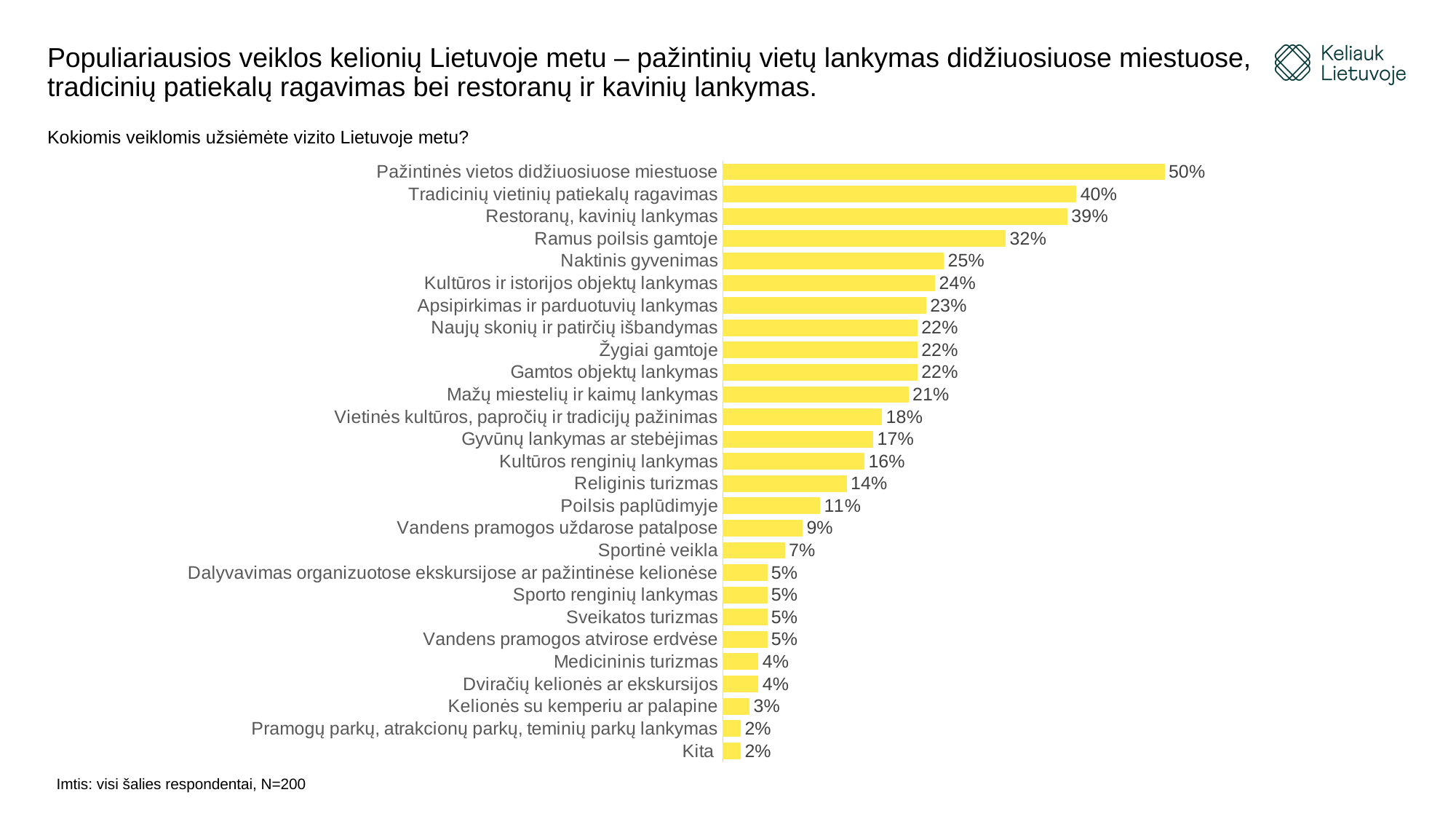
What is the value shown for "Religinis turizmas"? 14% What type of chart is shown on the slide? Bar chart What is the value shown for "Kita"? 2% Which is larger: the value for "Poilsis paplūdimyje" or the value for "Sportinė veikla"? Poilsis paplūdimyje What colour are the bars in the chart? Yellow What is the value shown for "Ramus poilsis gamtoje"? 32% What is the difference between the values for "Tradicinių vietinių patiekalų ragavimas" and "Naktinis gyvenimas"? 15% What percentage of respondents chose "Pažintinės vietos didžiuosiuose miestuose"? 50% What is the sample size stated below the chart? N=200 What is the lowest value shown in the chart? 2% How many activity categories are shown in the chart? 27 Which activity has the highest value in the chart? Pažintinės vietos didžiuosiuose miestuose